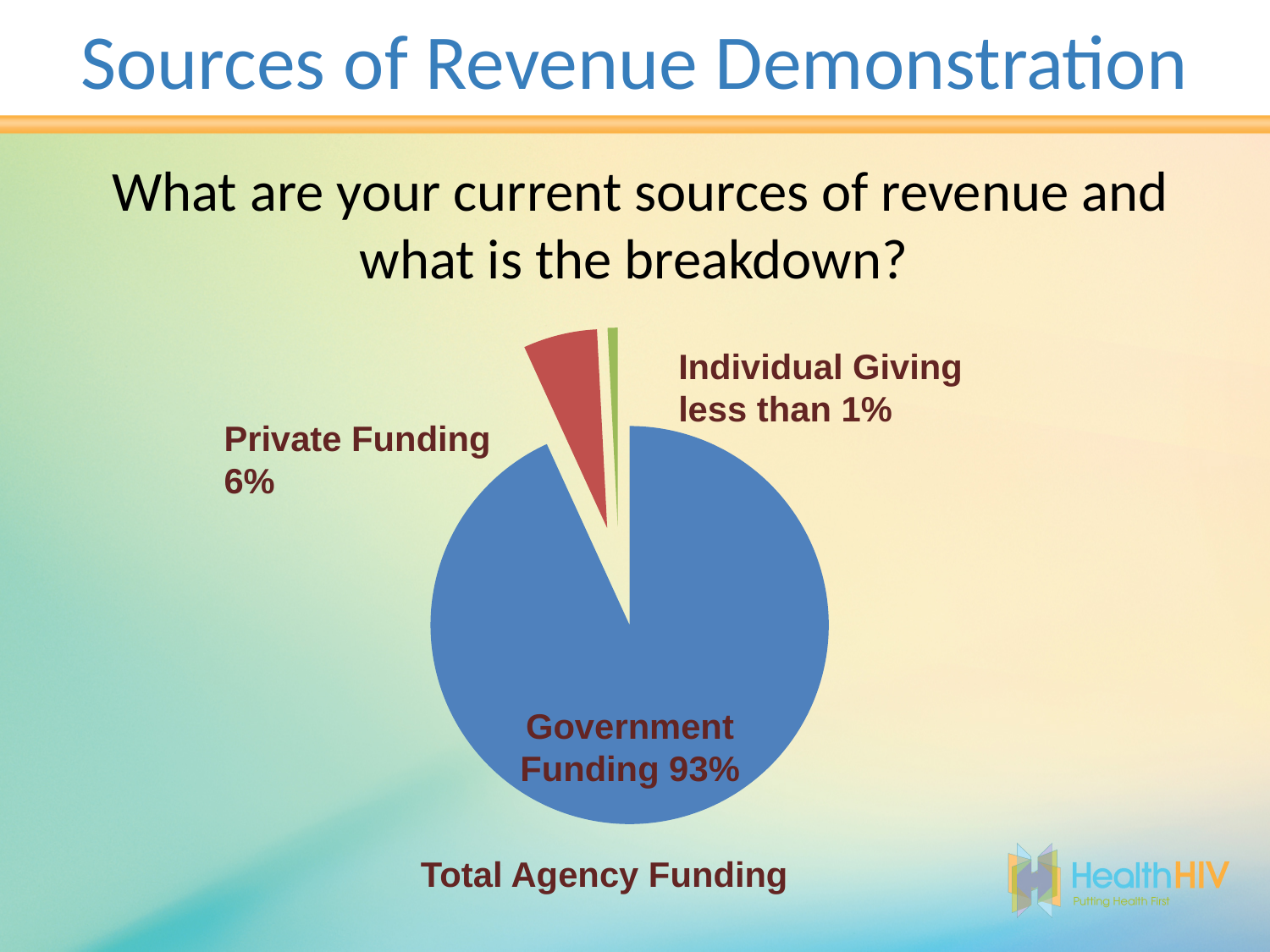
What is the difference in percentage points between Government Funding and Private Funding? 87 How many slices does the pie chart have? 3 What share of Total Agency Funding comes from Government Funding? 93% What colour is the Government Funding slice? Blue What share of Total Agency Funding comes from Private Funding? 6% Which is larger, Private Funding or Individual Giving? Private Funding What is the title shown below the pie chart? Total Agency Funding Which source of revenue has the smallest slice of the pie? Individual Giving What kind of chart is shown on the slide? Pie chart Which source of revenue has the largest slice of the pie? Government Funding What share of Total Agency Funding comes from Individual Giving? less than 1%